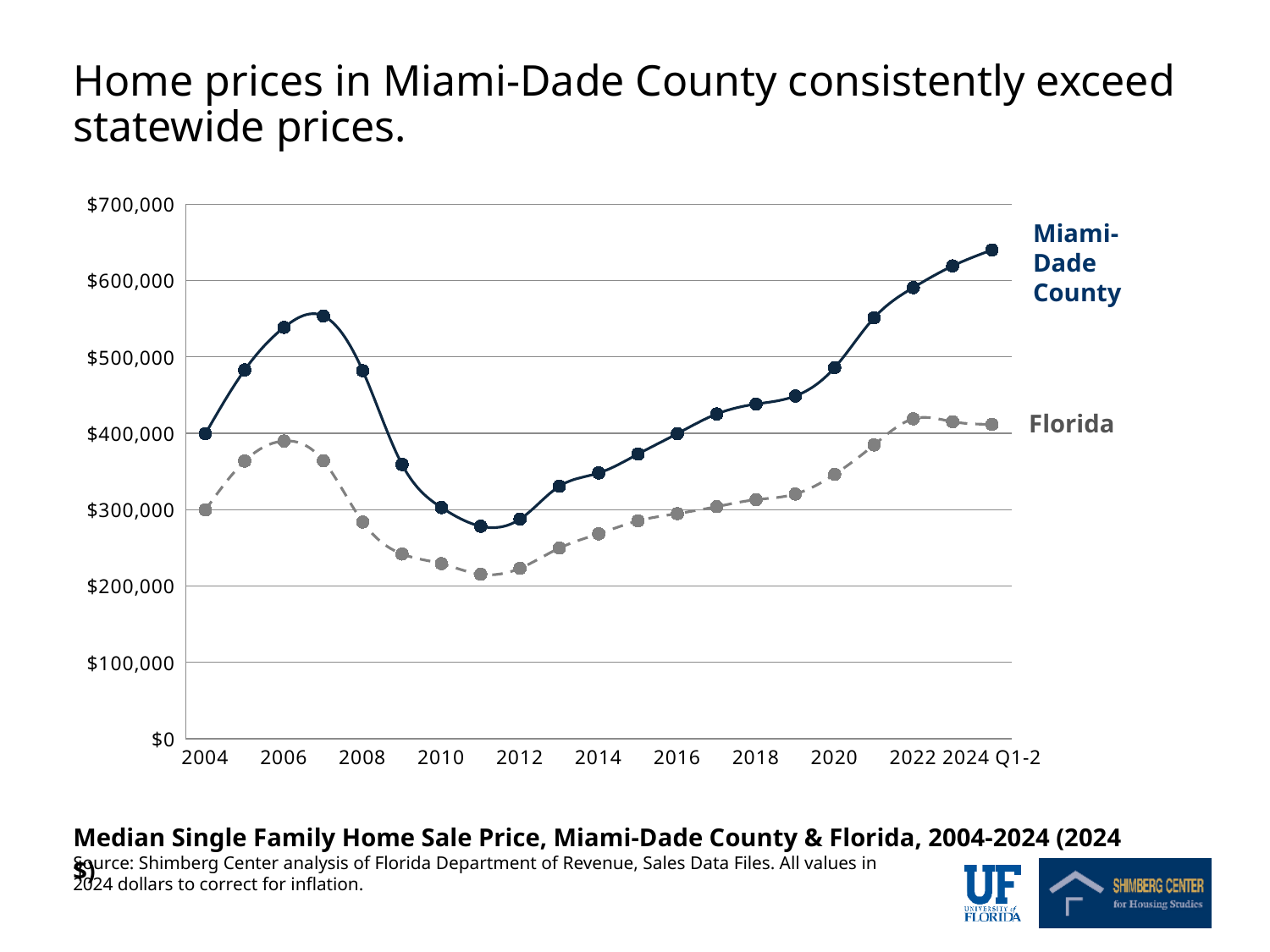
Is the Florida value for 2006 greater or less than $300,000? greater Is the Miami-Dade County value for 2024 Q1-2 greater or less than $600,000? greater Is the Florida value for 2011 greater or less than $300,000? less Which series has the higher median sale price in 2007, Miami-Dade County or Florida? Miami-Dade County How many series does the chart show? 2 Does the Miami-Dade County series rise or fall between 2012 and 2024 Q1-2? rise In which year does the Miami-Dade County series reach its highest value? 2024 Q1-2 What kind of chart is shown on the slide? line chart What is the title of the chart? Median Single Family Home Sale Price, Miami-Dade County & Florida, 2004-2024 (2024 $) Does the Miami-Dade County series rise or fall between 2007 and 2011? fall